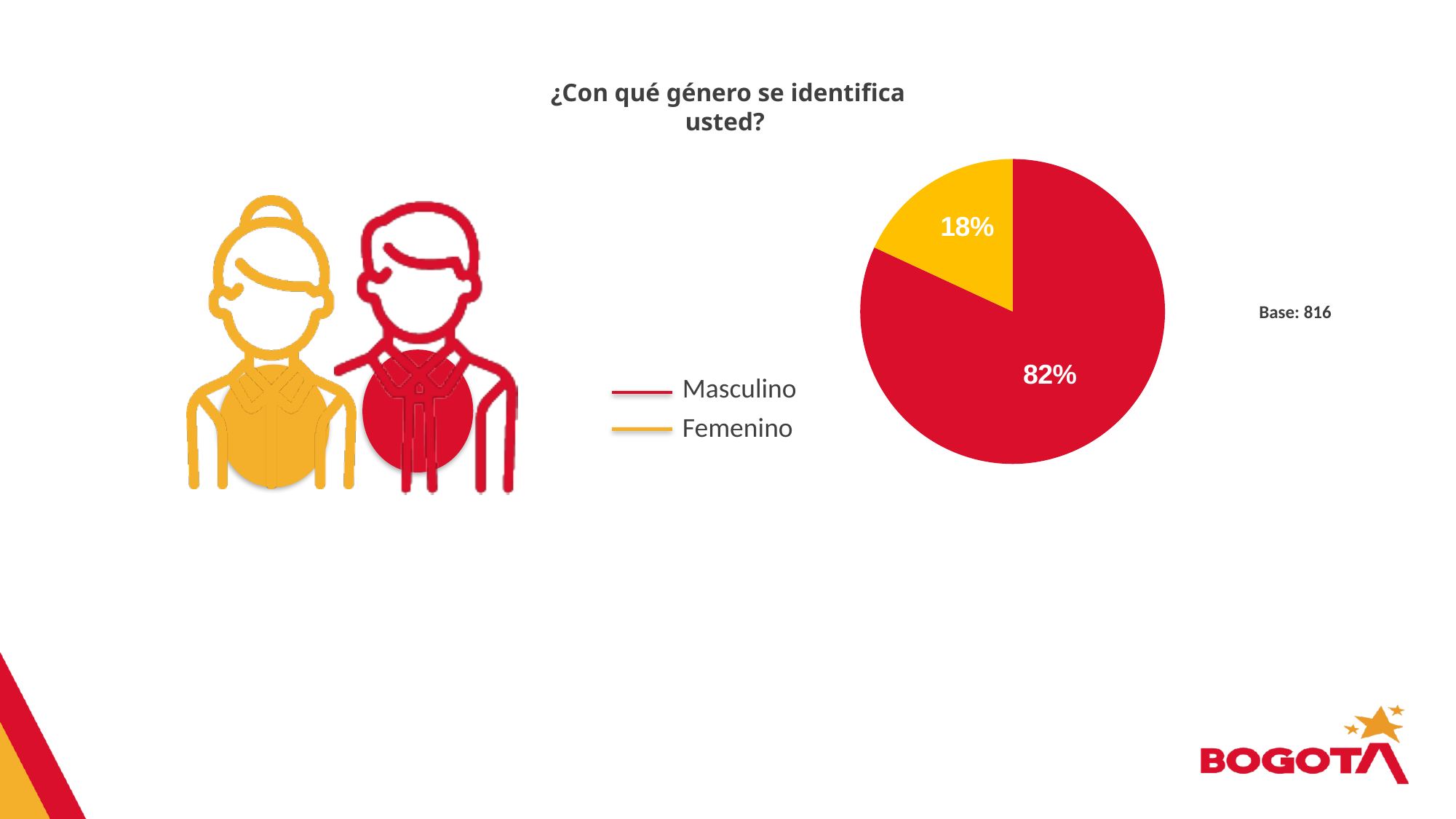
What share of the pie does the Masculino slice represent? 82% How many entries does the legend list? 2 Which category has the largest share of the pie? Masculino What kind of chart is shown on the slide? pie chart How many categories does the pie chart show? 2 Which is larger, the share for Masculino or for Femenino? Masculino What is the value for Masculino? 82% Which category has the smallest share of the pie? Femenino What is the title of the chart? ¿Con qué género se identifica usted? What colour is the Femenino slice? yellow What is the value for Femenino? 18% What is the difference between the Masculino and Femenino shares? 64%